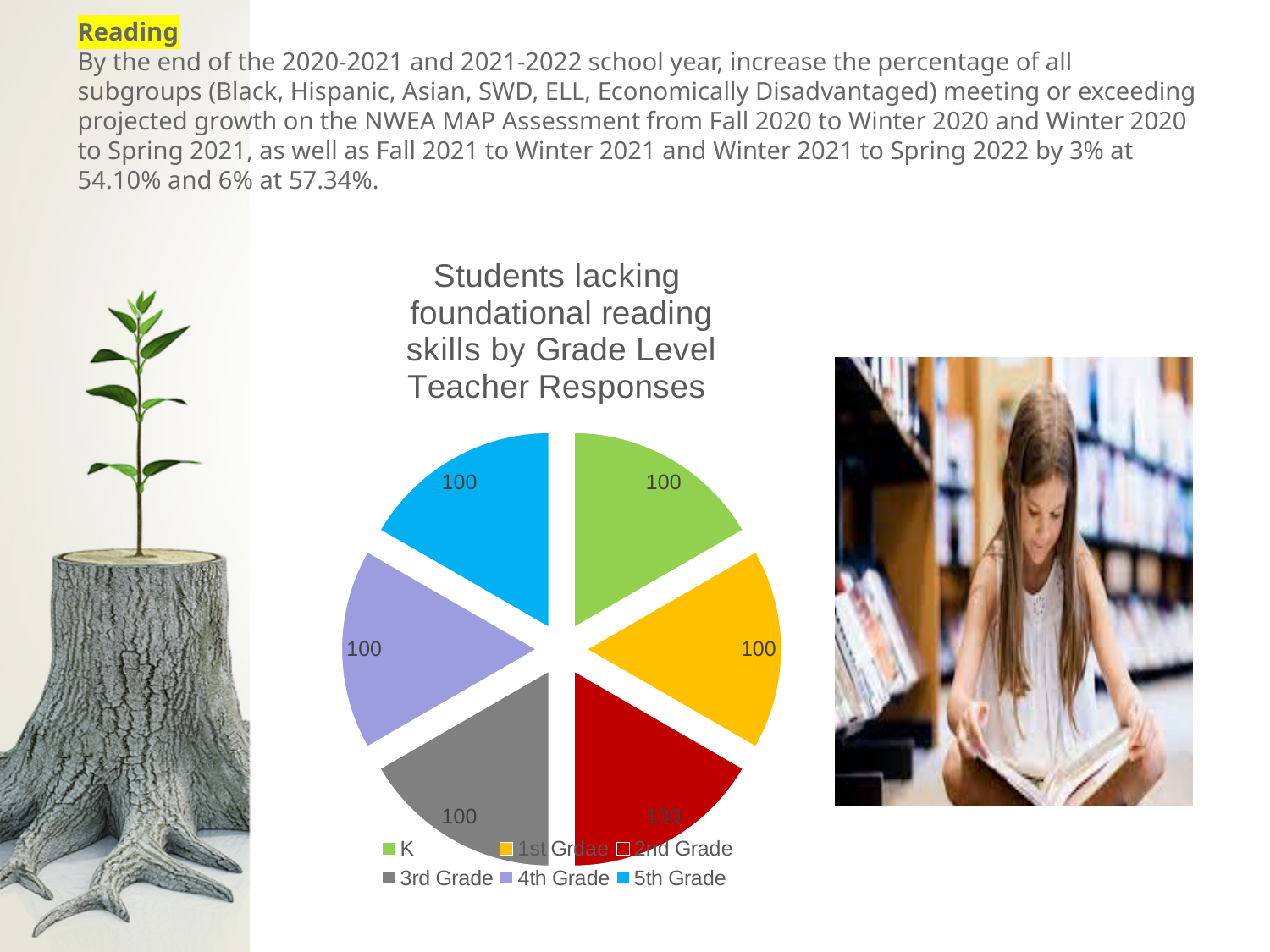
What is the value shown for 3rd Grade? 100 How many entries does the chart legend list? 6 What is the title of the chart? Students lacking foundational reading skills by Grade Level Teacher Responses How many slices does the pie chart have? 6 What is the value shown for 4th Grade? 100 What is the value shown for 2nd Grade? 100 What is the value shown for 5th Grade? 100 What is the value shown for K? 100 Which legend entry is shown in green? K What is the total of all the slice values in the pie chart? 600 What kind of chart is shown on the slide? pie chart What is the difference between the values for K and 5th Grade? 0